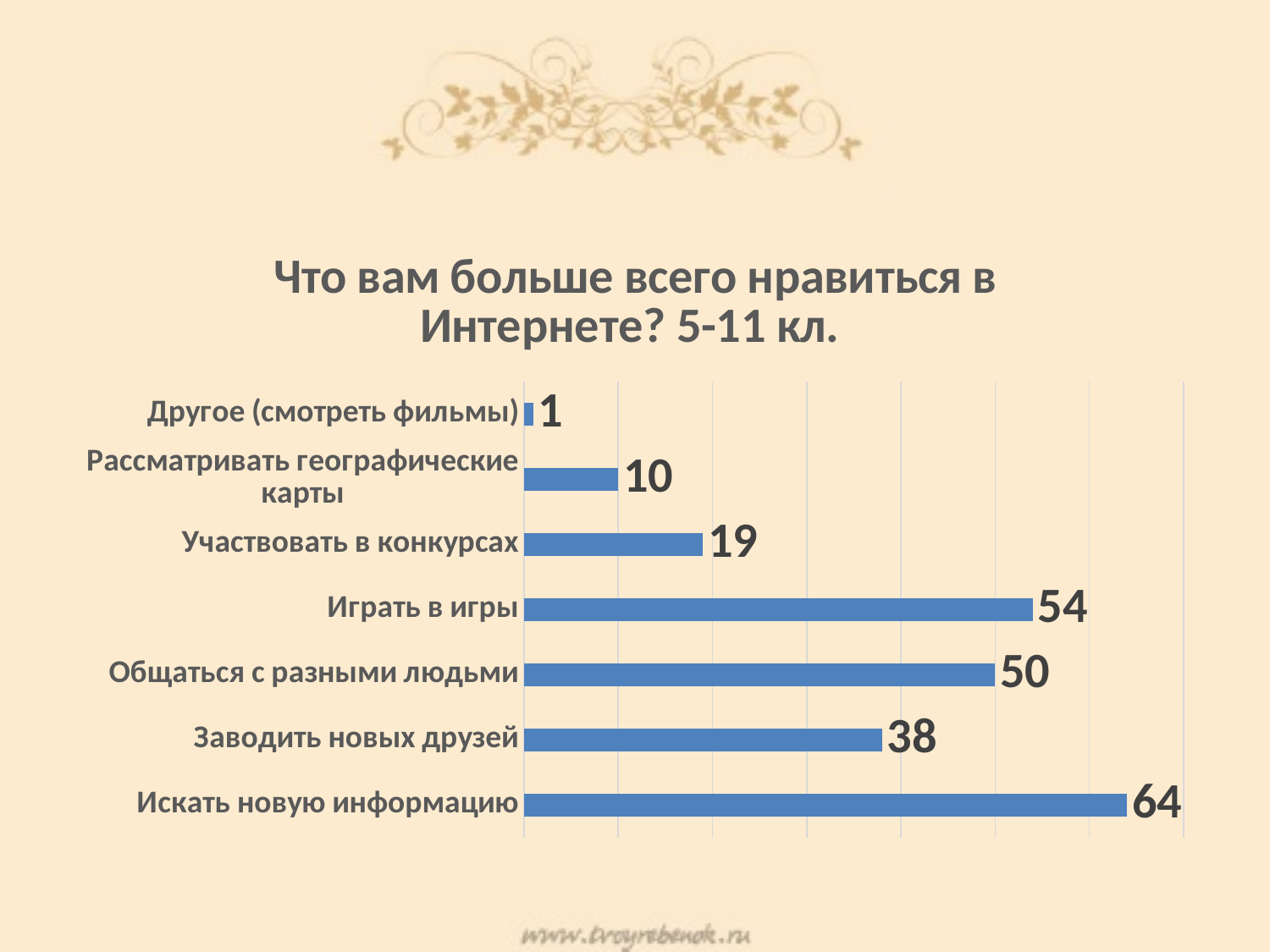
What is the value for "Рассматривать географические карты"? 10 What is the difference between the values for "Играть в игры" and "Общаться с разными людьми"? 4 What is the title of the chart? Что вам больше всего нравиться в Интернете? 5-11 кл. What is the value for "Искать новую информацию"? 64 What is the value for "Участвовать в конкурсах"? 19 What is the value for "Заводить новых друзей"? 38 What is the difference between the values for "Искать новую информацию" and "Заводить новых друзей"? 26 Which category has the lowest value? Другое (смотреть фильмы) Which is larger: the value for "Играть в игры" or the value for "Заводить новых друзей"? Играть в игры How many categories are shown in the chart? 7 Which category has the highest value? Искать новую информацию What kind of chart is shown on the slide? Bar chart